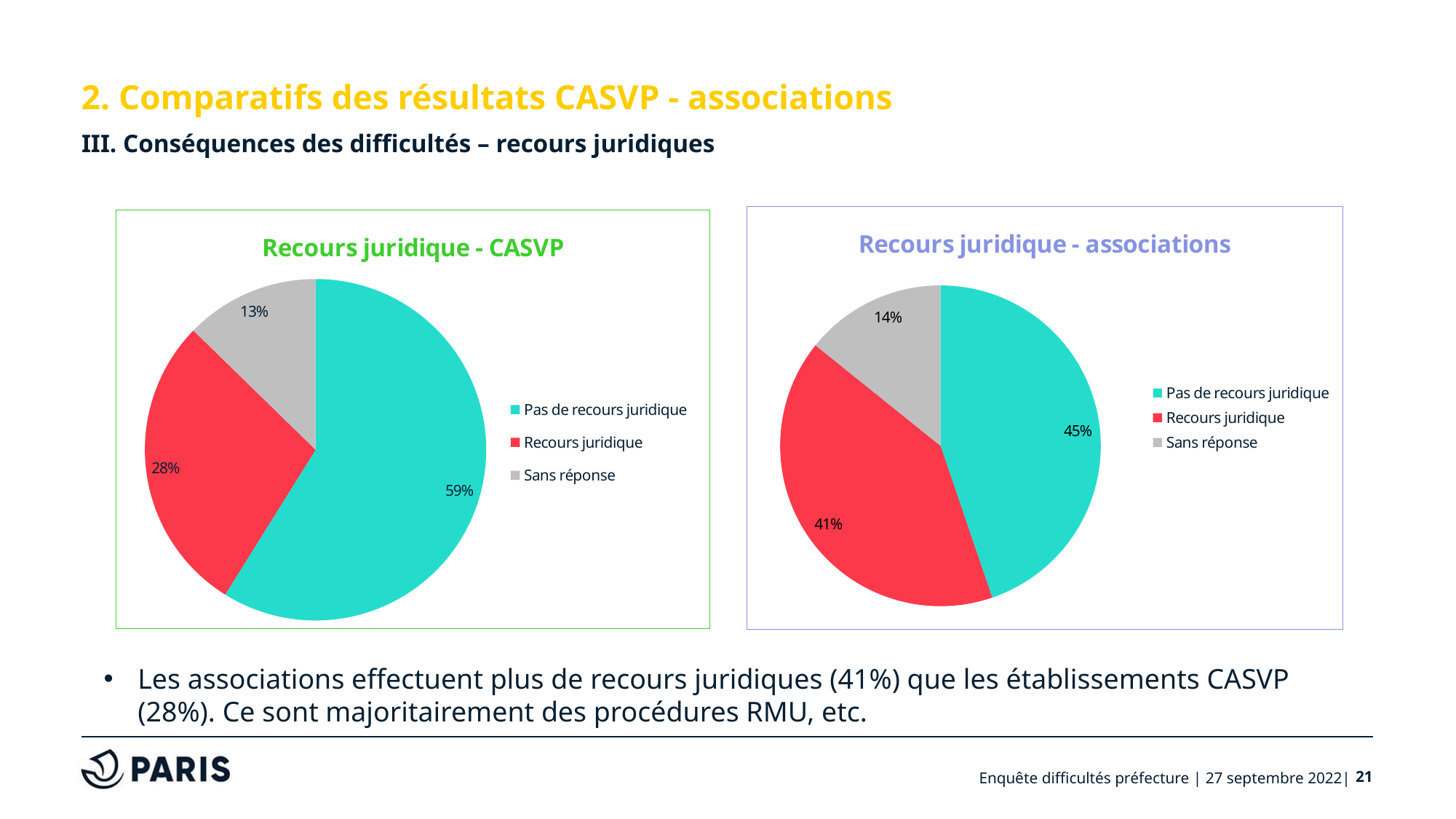
How many categories does the 'Recours juridique - associations' chart show? 3 In the 'Recours juridique - associations' chart, what share is labelled for 'Recours juridique'? 41% In the 'Recours juridique - associations' chart, which category has the largest slice? Pas de recours juridique In the 'Recours juridique - associations' chart, what share is labelled for 'Sans réponse'? 14% Which chart shows a larger share for 'Pas de recours juridique', the CASVP chart or the associations chart? Recours juridique - CASVP In the 'Recours juridique - CASVP' chart, what share is labelled for 'Sans réponse'? 13% What is the difference between the 'Recours juridique' share in the associations chart and the 'Recours juridique' share in the CASVP chart? 13 percentage points In the 'Recours juridique - CASVP' chart, what share is labelled for 'Recours juridique'? 28% In the 'Recours juridique - CASVP' chart, which category has the smallest slice? Sans réponse In the 'Recours juridique - CASVP' chart, what colour represents 'Recours juridique'? Red In the 'Recours juridique - CASVP' chart, what share is labelled for 'Pas de recours juridique'? 59% What type of chart is 'Recours juridique - CASVP'? Pie chart